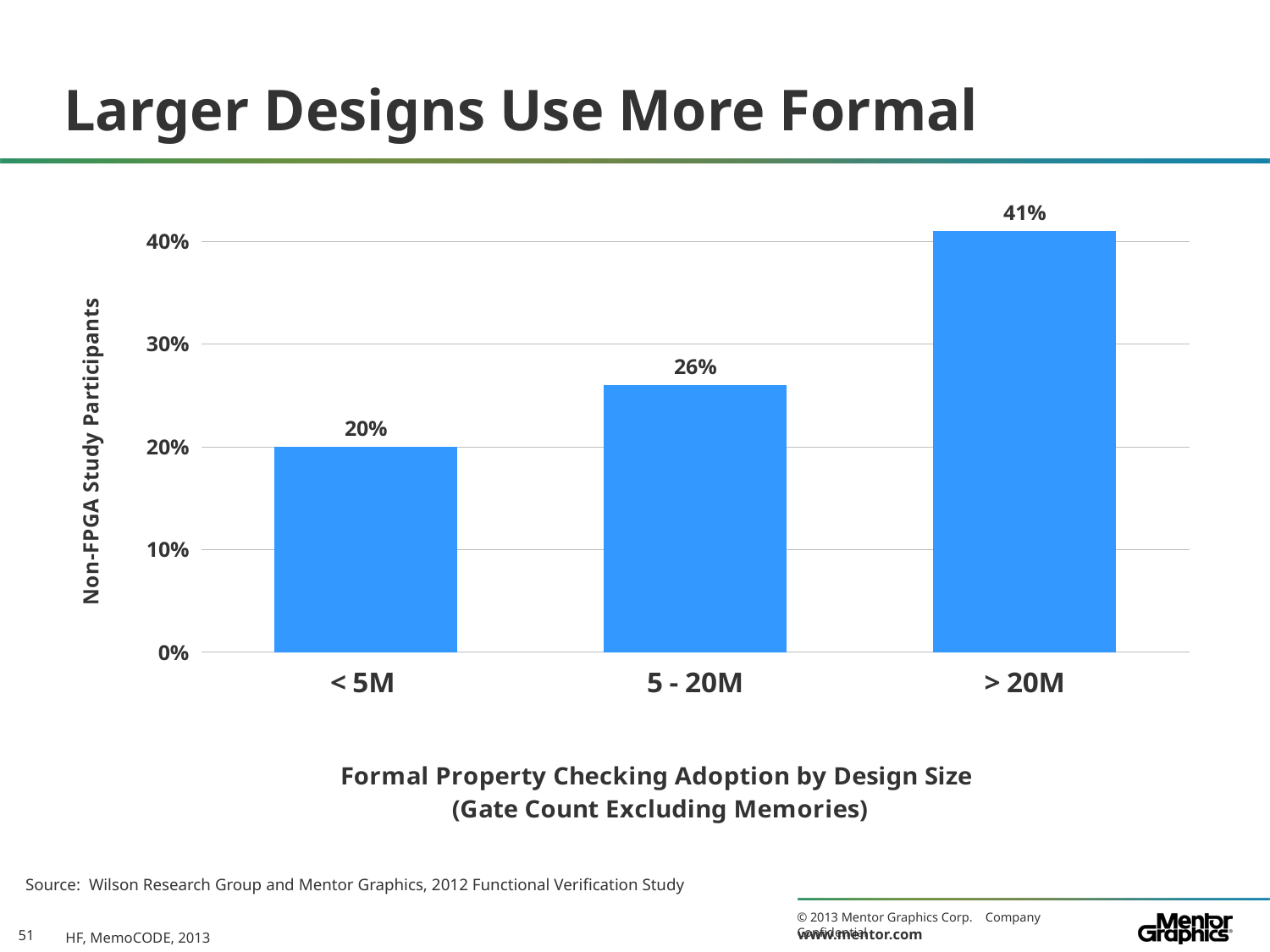
What is the value for the 5 - 20M design size category? 26% Which design size category has the highest formal property checking adoption? > 20M What kind of chart is shown on the slide? bar chart What is the difference in percentage points between the > 20M and < 5M categories? 21% How many design size categories are shown on the x axis? 3 What is the difference in percentage points between the 5 - 20M and < 5M categories? 6% Which design size category has the lowest formal property checking adoption? < 5M Which is larger, the value for 5 - 20M or the value for > 20M? > 20M What is the value for the < 5M design size category? 20% Do the values rise or fall as design size increases along the x axis? rise Is the value for > 20M greater or less than 40%? greater What is the value for the > 20M design size category? 41%